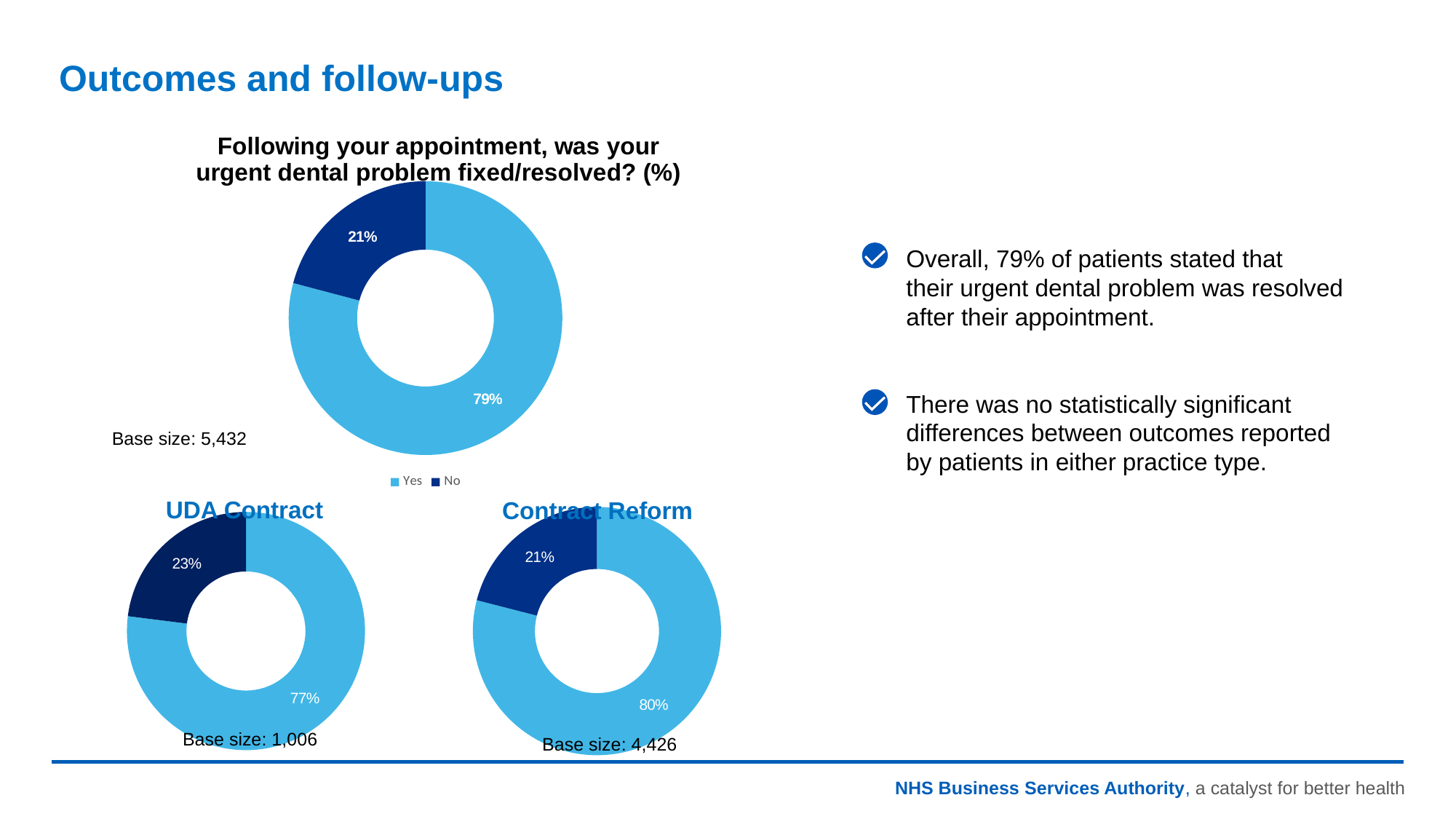
Which chart shows the higher Yes percentage, UDA Contract or Contract Reform? Contract Reform In the UDA Contract chart, what is the difference between the Yes and No percentages? 54% In the UDA Contract chart, what percentage answered Yes? 77% In the top chart titled 'Following your appointment, was your urgent dental problem fixed/resolved? (%)', what percentage answered Yes? 79% In the top chart, which response has the larger share, Yes or No? Yes What is the base size shown for the UDA Contract chart? 1,006 In the top chart titled 'Following your appointment, was your urgent dental problem fixed/resolved? (%)', what percentage answered No? 21% In the UDA Contract chart, what percentage answered No? 23% How many entries does the legend of the top chart list? 2 In the Contract Reform chart, what percentage answered No? 21% In the Contract Reform chart, what percentage answered Yes? 80% What type of chart is the top chart titled 'Following your appointment, was your urgent dental problem fixed/resolved? (%)'? Doughnut (pie) chart